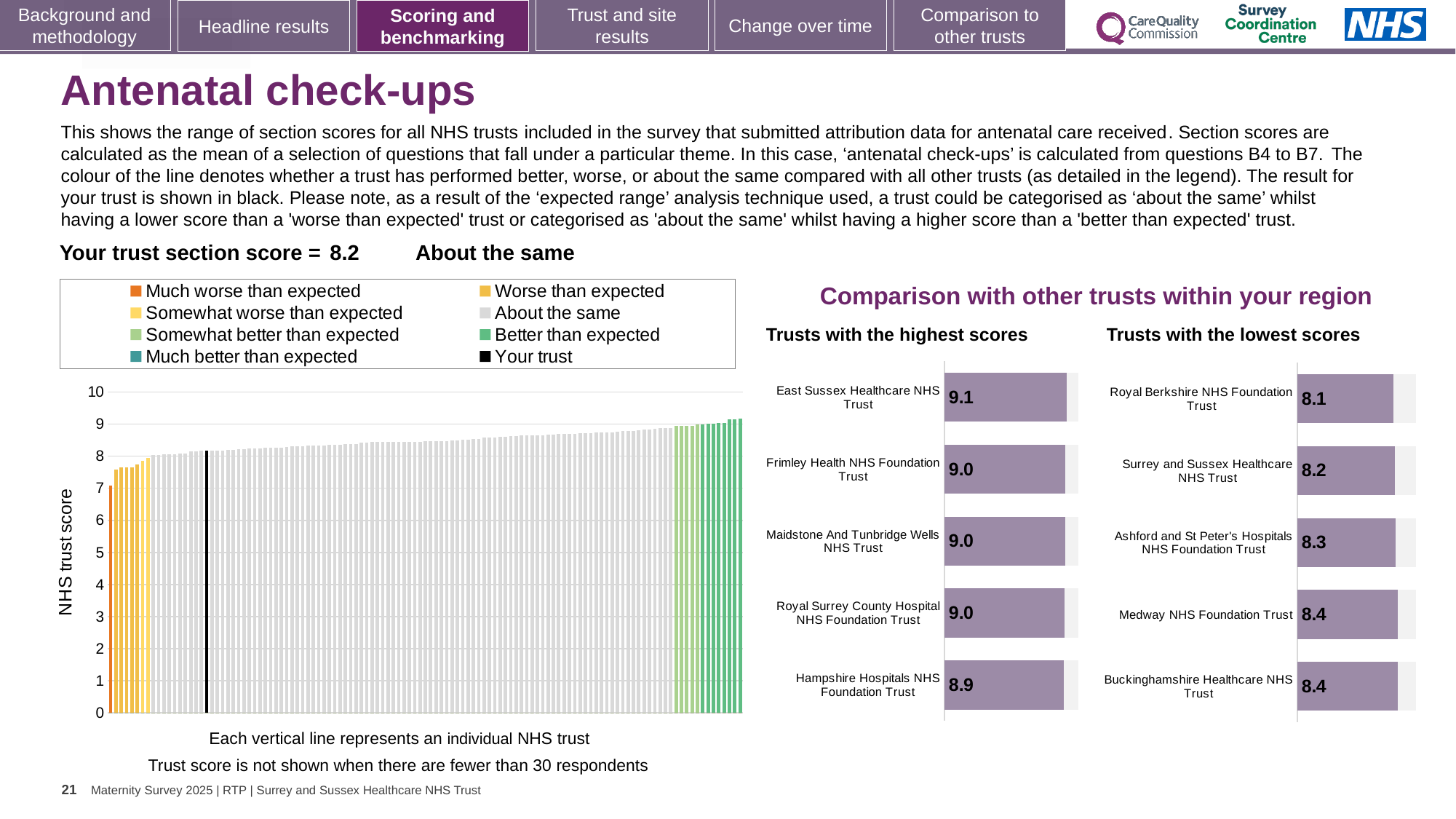
In the 'Trusts with the highest scores' chart, which trust has the highest score? East Sussex Healthcare NHS Trust What kind of chart is the large chart on the left with the y-axis labelled 'NHS trust score'? Bar chart In the 'Trusts with the highest scores' chart, what is the score for Hampshire Hospitals NHS Foundation Trust? 8.9 In the 'Trusts with the lowest scores' chart, which trust has the lowest score? Royal Berkshire NHS Foundation Trust In the 'Trusts with the lowest scores' chart, which has the larger score: Ashford and St Peter's Hospitals NHS Foundation Trust or Surrey and Sussex Healthcare NHS Trust? Ashford and St Peter's Hospitals NHS Foundation Trust How many entries does the legend above the large chart on the left list? 8 In the 'Trusts with the highest scores' chart, what is the difference between the scores of East Sussex Healthcare NHS Trust and Hampshire Hospitals NHS Foundation Trust? 0.2 In the 'Trusts with the lowest scores' chart, what is the score for Royal Berkshire NHS Foundation Trust? 8.1 In the 'Trusts with the lowest scores' chart, what is the difference between the scores of Medway NHS Foundation Trust and Royal Berkshire NHS Foundation Trust? 0.3 In the large chart on the left, do the trust scores rise or fall from left to right? Rise In the 'Trusts with the highest scores' chart, what is the score for East Sussex Healthcare NHS Trust? 9.1 In the 'Trusts with the highest scores' chart, how many trusts are shown? 5